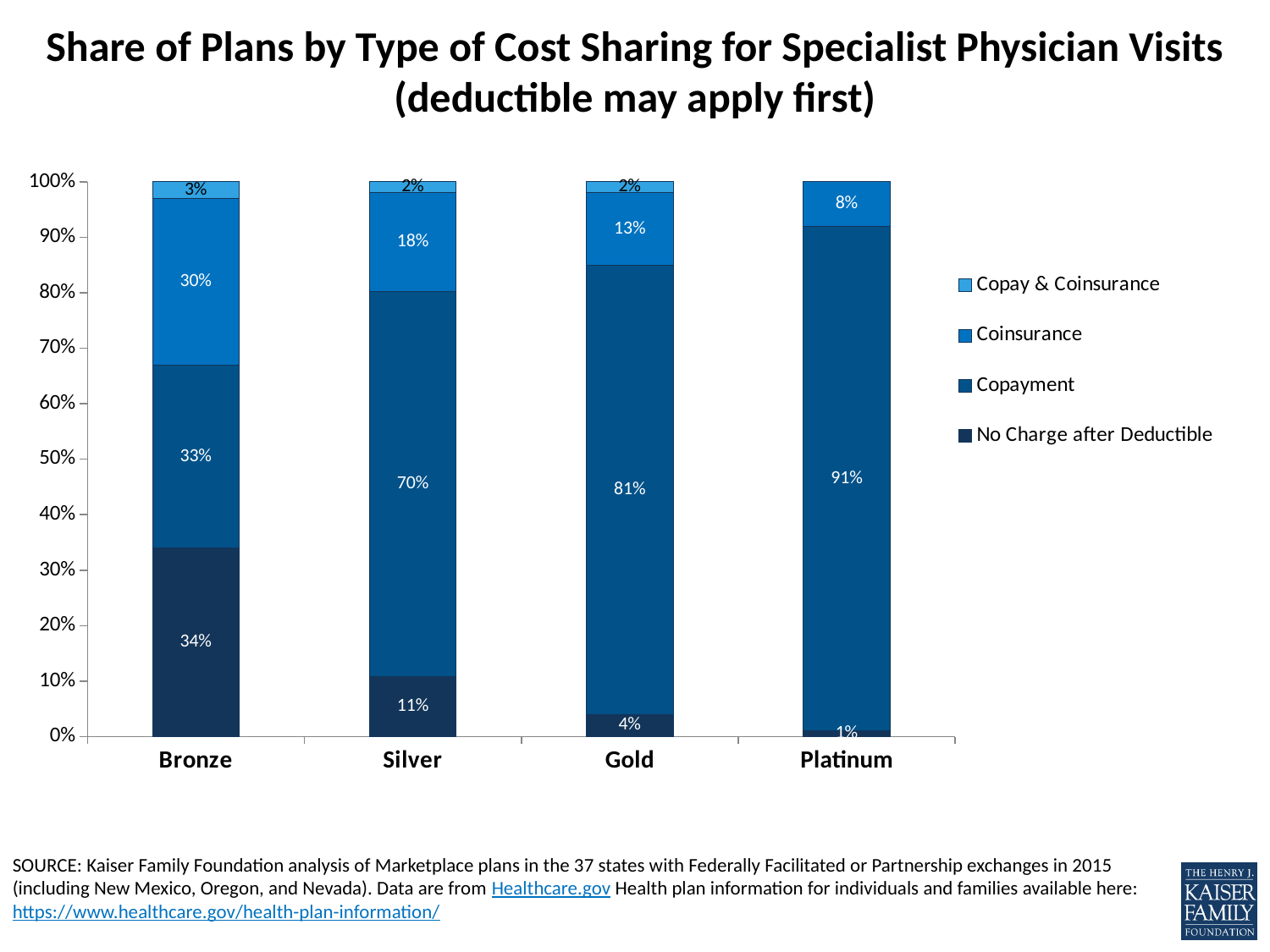
Which plan type has the highest Copayment share? Platinum What is the No Charge after Deductible share for Bronze plans? 34% What is the Coinsurance share for Gold plans? 13% What kind of chart is shown on the slide? Stacked bar chart Which has a larger Coinsurance share, Bronze or Silver? Bronze What is the difference between the Copayment share for Gold and for Silver? 11 percentage points What is the Copay & Coinsurance share for Bronze plans? 3% What is the Copayment share for Silver plans? 70% Which plan type has the lowest No Charge after Deductible share? Platinum How many series does the legend list? 4 How many plan types are shown on the x axis? 4 Does the Copayment share rise or fall from Bronze to Platinum? Rises